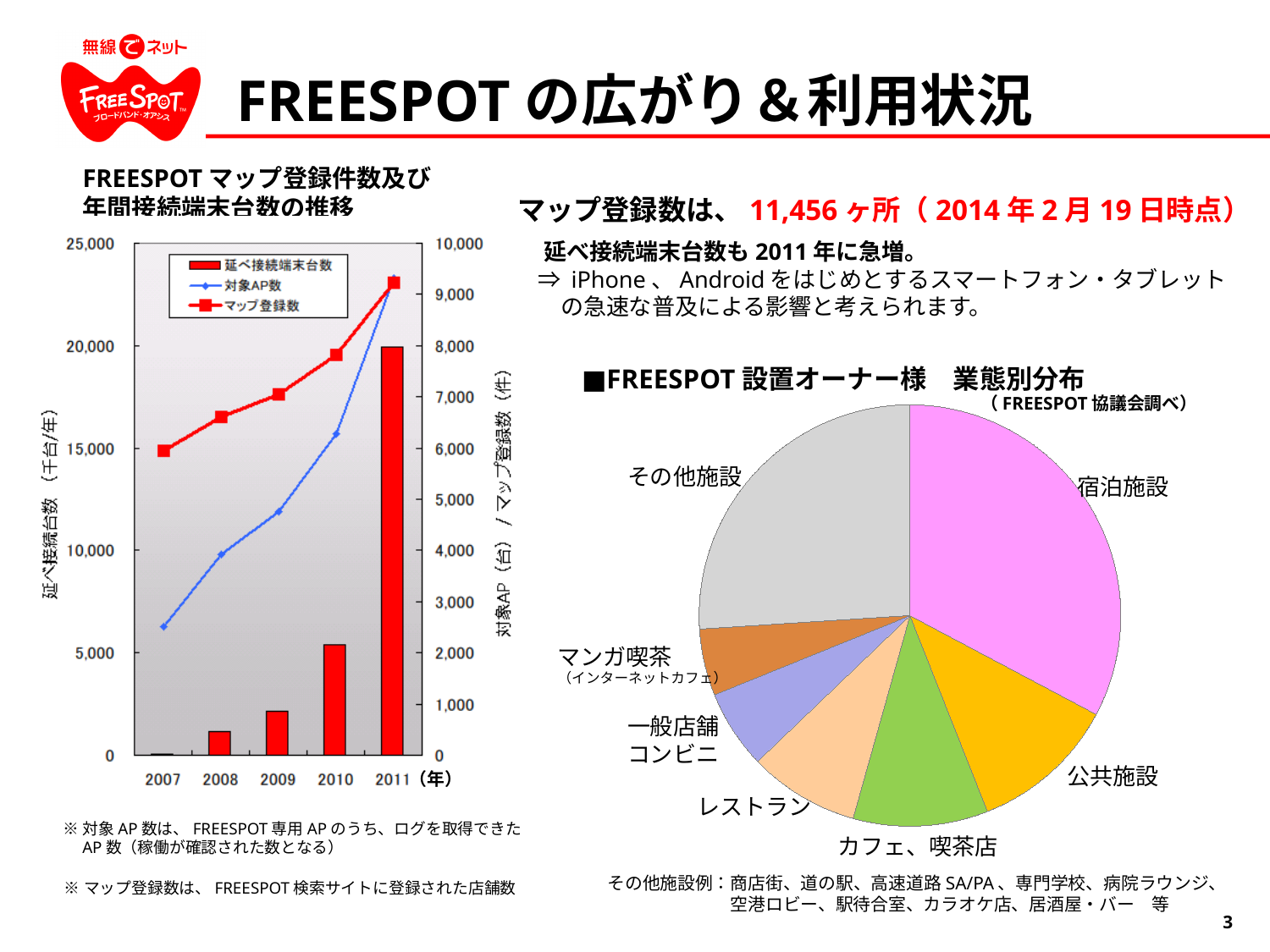
In the left chart, which is higher in 2010, マップ登録数 or 対象AP数? マップ登録数 In the left chart, how many years are shown on the x axis? 5 In the pie chart 'FREESPOT 設置オーナー様 業態別分布', which category has the largest slice? 宿泊施設 In the left chart, is the 対象AP数 value for 2007 greater or less than 3,000 on the right axis? less In the left chart, how many series does the legend list? 3 In the left chart, does the マップ登録数 line rise or fall from 2007 to 2011? rises What type of chart is the left chart titled 'FREESPOT マップ登録件数及び年間接続端末台数の推移'? A combination bar and line chart In the left chart, is the マップ登録数 value for 2007 greater or less than 5,000 on the right axis? greater In the left chart, is the 延べ接続端末台数 bar for 2010 greater or less than 10,000 on the left axis? less In the left chart, which year has the lowest 延べ接続端末台数 bar? 2007 In the left chart, which year has the highest 延べ接続端末台数 bar? 2011